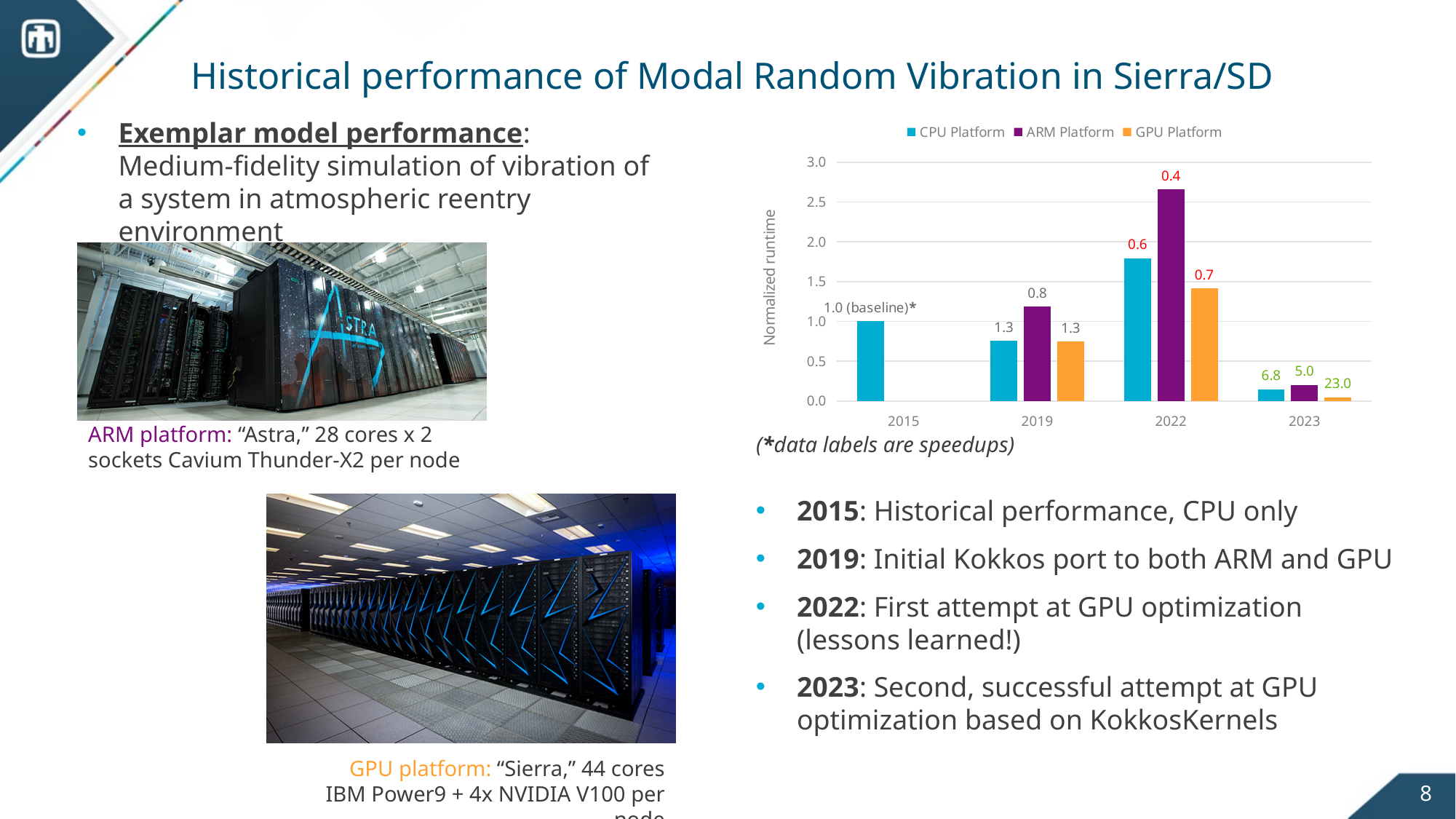
Is the normalized runtime for the ARM Platform in 2022 greater or less than 2.5? greater How many series does the chart legend list? 3 What speedup data label is printed on the ARM Platform bar for 2022? 0.4 How many year categories are shown on the x axis of the chart? 4 Is the normalized runtime for the CPU Platform in 2023 greater or less than 0.5? less Which bar in the chart has the highest normalized runtime? ARM Platform in 2022 Is the normalized runtime for the GPU Platform in 2022 greater or less than 1.5? less In 2022, which has the larger normalized runtime, the CPU Platform or the ARM Platform? ARM Platform What is the label of the y axis of the chart? Normalized runtime What kind of chart is shown on the slide? bar chart What speedup data label is printed on the GPU Platform bar for 2023? 23.0 Which bar in the chart has the lowest normalized runtime? GPU Platform in 2023